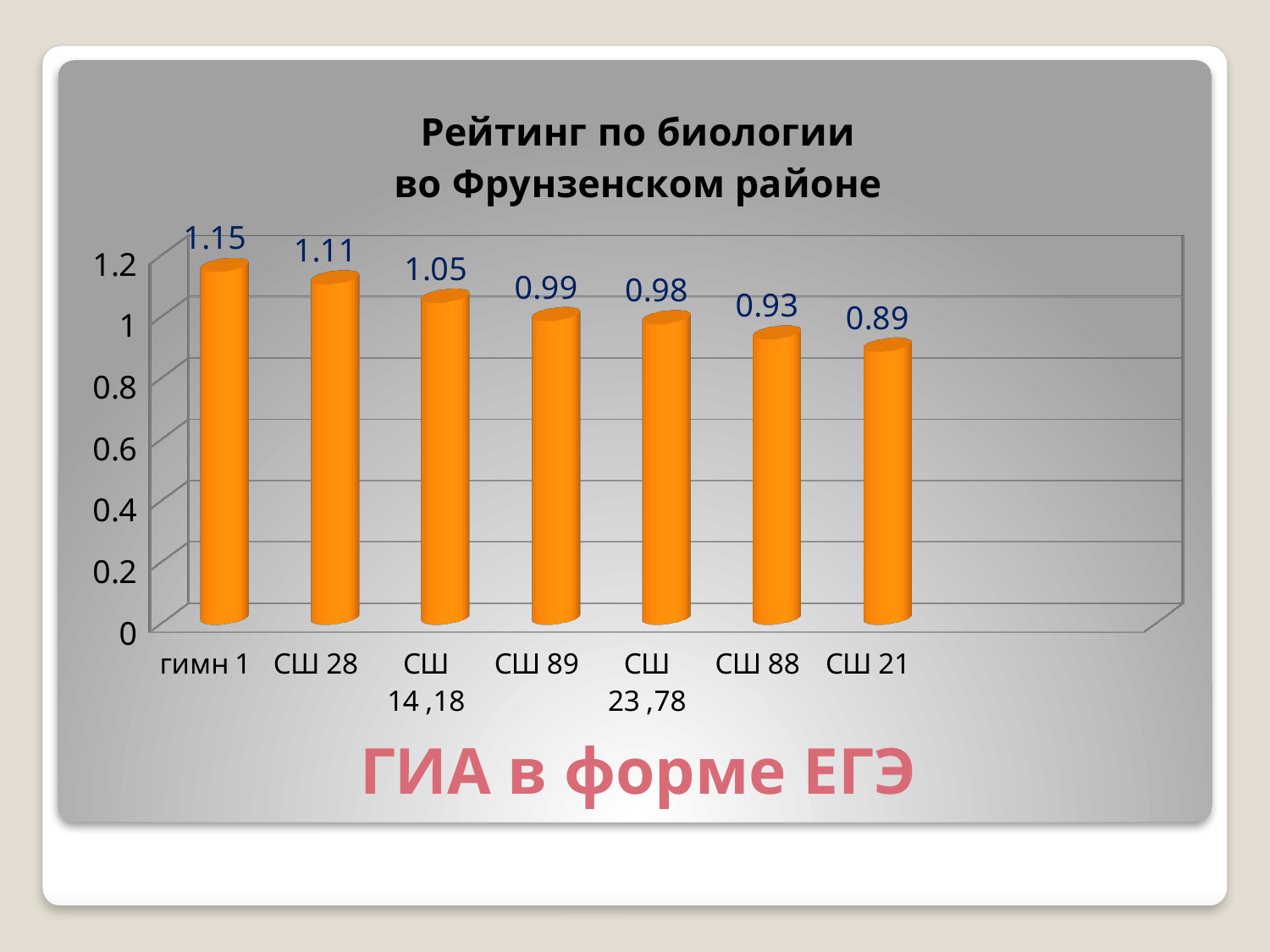
Do the values rise or fall from left to right along the x axis? fall What is the value for СШ 89? 0.99 Which category has the lowest value? СШ 21 What is the value for СШ 21? 0.89 What is the value for гимн 1? 1.15 Which is larger, the value for СШ 28 or the value for СШ 14,18? СШ 28 Which category has the highest value? гимн 1 How many categories are shown on the x axis? 7 What kind of chart is shown on the slide? bar chart Is the value for СШ 88 greater or less than 1? less What is the difference between the values for СШ 28 and СШ 88? 0.18 What is the difference between the values for гимн 1 and СШ 21? 0.26